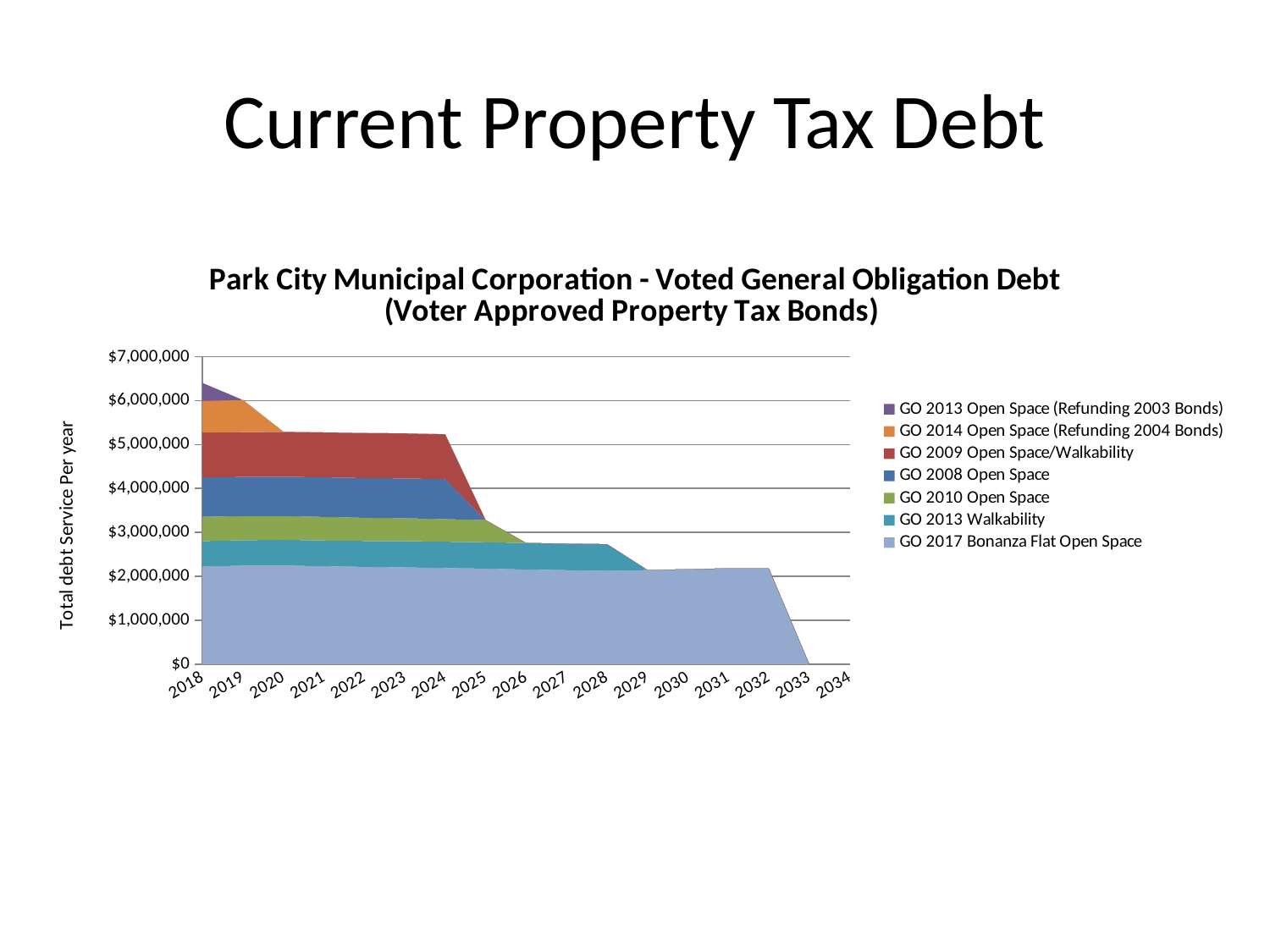
Is the total debt service in 2030 greater or less than $3,000,000? less How many years are shown along the x axis? 17 What is the label on the y axis? Total debt Service Per year Which series forms the bottom layer of the stacked area? GO 2017 Bonanza Flat Open Space Does the total debt service rise or fall from 2018 to 2034? Fall Is the total debt service in 2018 greater or less than $6,000,000? greater Is the total debt service in 2024 greater or less than $5,000,000? greater How many series does the legend list? 7 What kind of chart is shown on the slide? Stacked area chart Which is larger, the total debt service in 2018 or in 2030? 2018 In which year is the total debt service highest? 2018 Which series is the last to reach zero, ending after 2032? GO 2017 Bonanza Flat Open Space